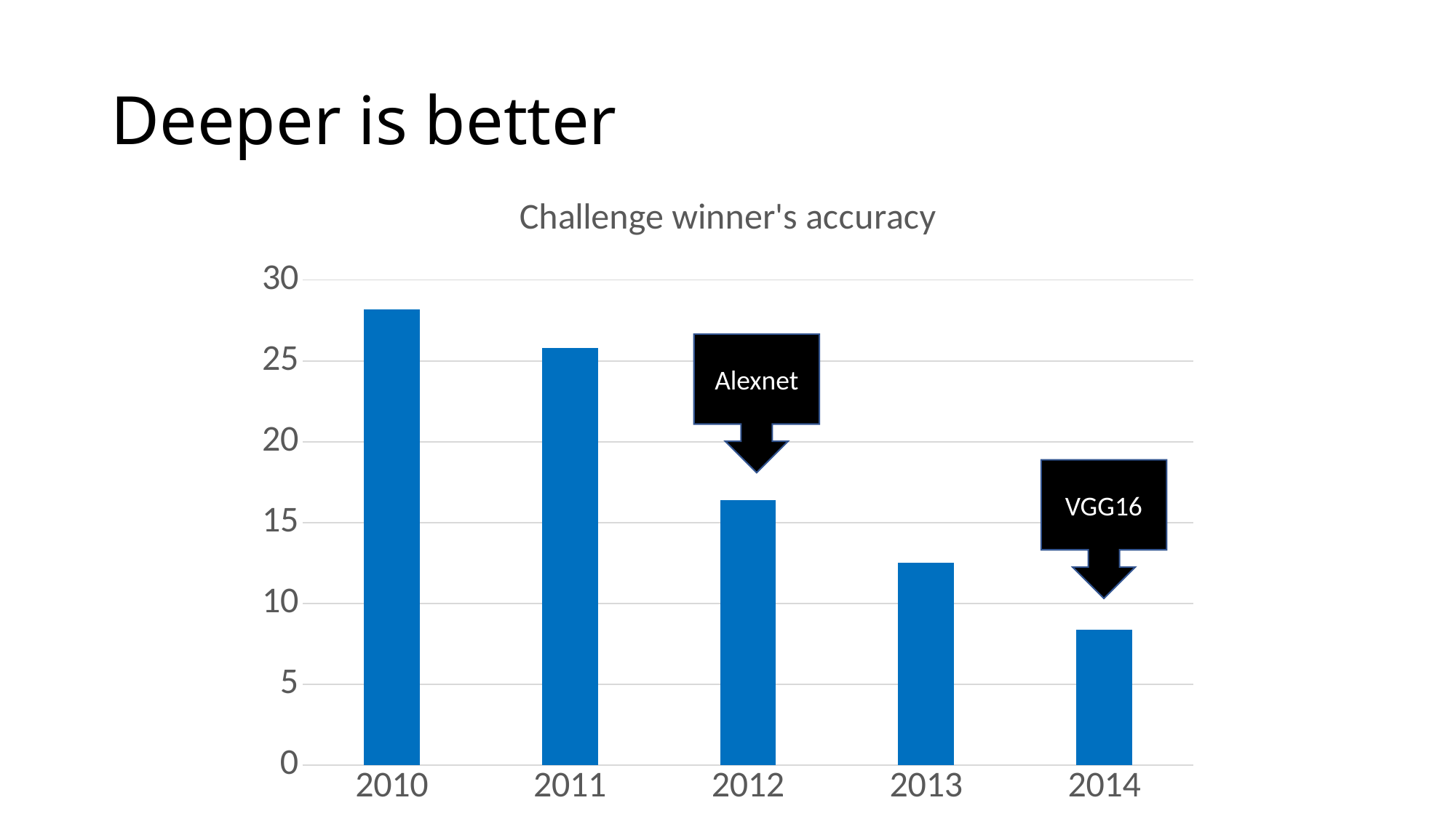
Is the value for 2010 greater or less than 25? greater Is the value for 2012 greater or less than 20? less Is the value for 2014 greater or less than 10? less What is the title of the chart? Challenge winner's accuracy Which year's bar is labelled with the annotation "Alexnet"? 2012 What kind of chart is shown on the slide? bar chart Which year has the lowest bar in the chart? 2014 Which is larger, the value for 2011 or the value for 2012? 2011 How many years are shown on the x axis of the chart? 5 Do the values rise or fall from 2010 to 2014? fall Which year has the highest bar in the chart? 2010